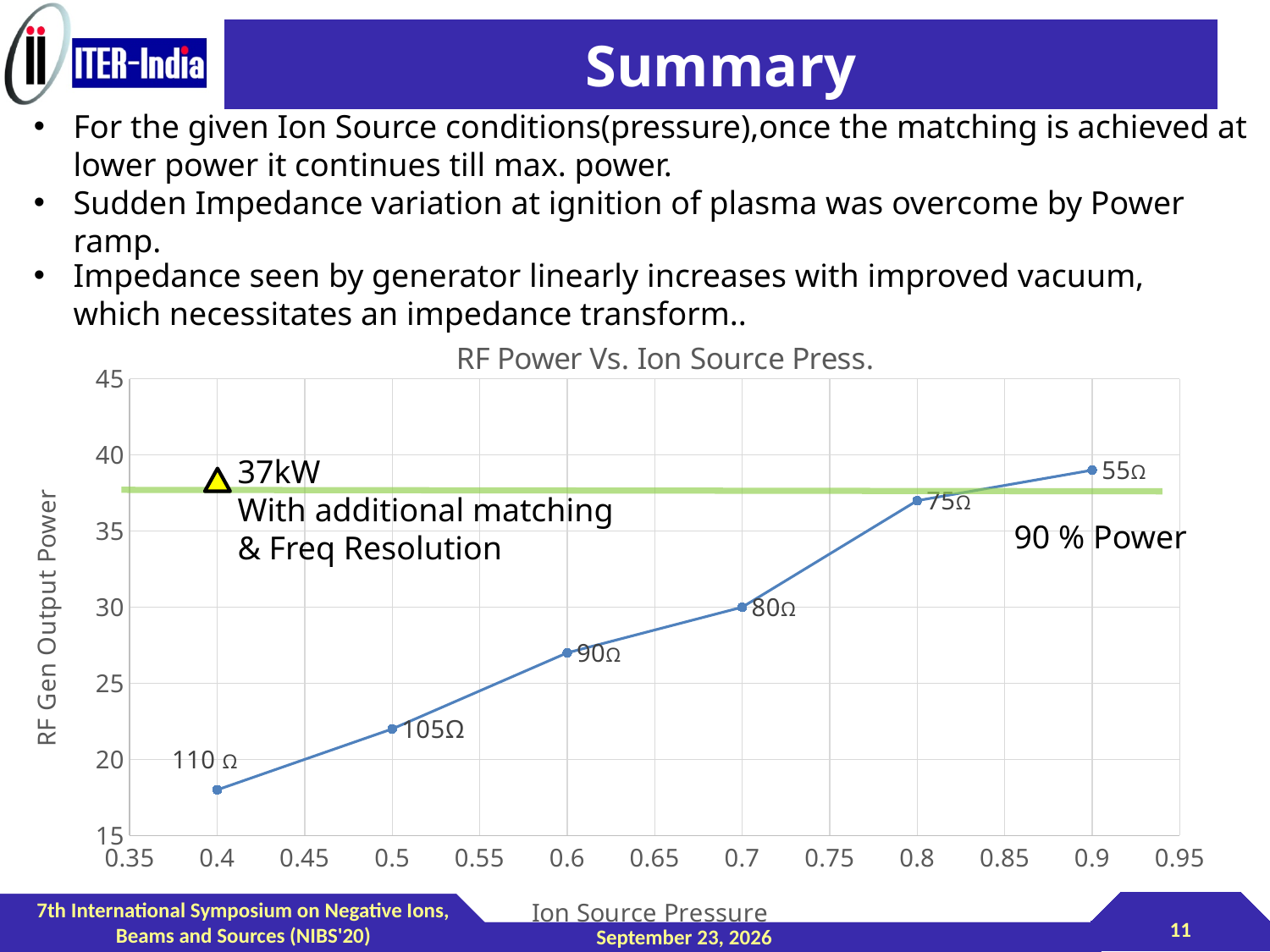
Which has a higher RF Gen Output Power: Ion Source Pressure 0.5 or 0.7? 0.7 Is the RF Gen Output Power at Ion Source Pressure 0.6 greater or less than 25? greater Does the RF Gen Output Power rise or fall as Ion Source Pressure increases along the x axis? rise What impedance label is shown next to the data point at Ion Source Pressure 0.5? 105Ω What kind of chart is shown on the slide? line chart At which Ion Source Pressure is the RF Gen Output Power lowest? 0.4 At which Ion Source Pressure is the RF Gen Output Power highest? 0.9 How many data points are plotted on the line in the chart? 6 What is the title of the chart? RF Power Vs. Ion Source Press. What impedance label is shown next to the data point at Ion Source Pressure 0.9? 55Ω Is the RF Gen Output Power at Ion Source Pressure 0.8 greater or less than 35? greater Is the RF Gen Output Power at Ion Source Pressure 0.4 greater or less than 20? less